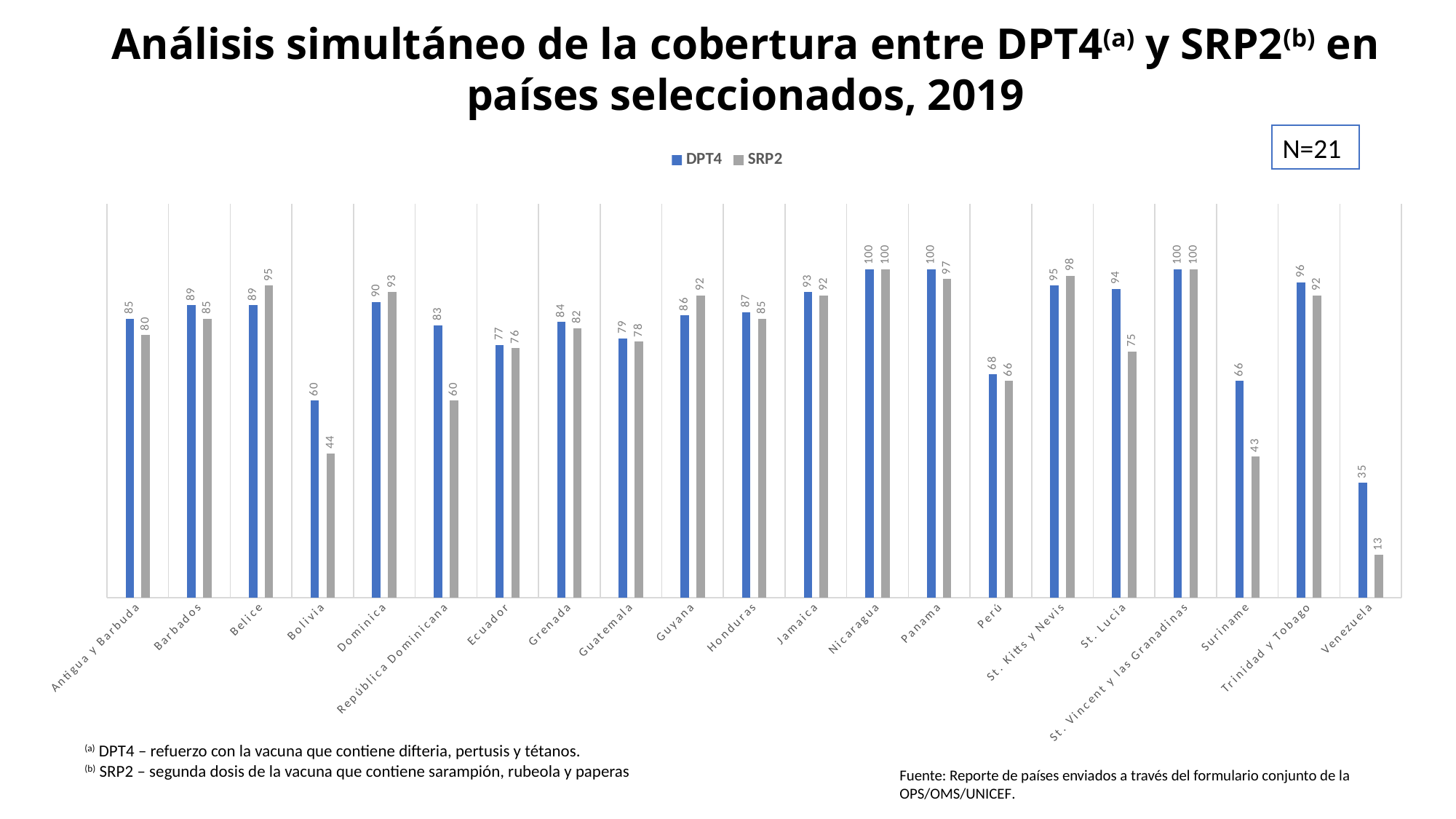
What kind of chart is shown on the slide? Bar chart Which is larger for Belice, the DPT4 value or the SRP2 value? SRP2 What is the difference between the DPT4 and SRP2 values for República Dominicana? 23 What is the SRP2 value for Venezuela? 13 What is the DPT4 value for Bolivia? 60 How many series does the legend list? 2 What colour are the DPT4 bars? Blue How many countries are shown on the x axis? 21 Which country has the lowest DPT4 value? Venezuela What is the difference between the DPT4 and SRP2 values for Suriname? 23 Which country has the lowest SRP2 value? Venezuela What is the SRP2 value for St. Lucia? 75